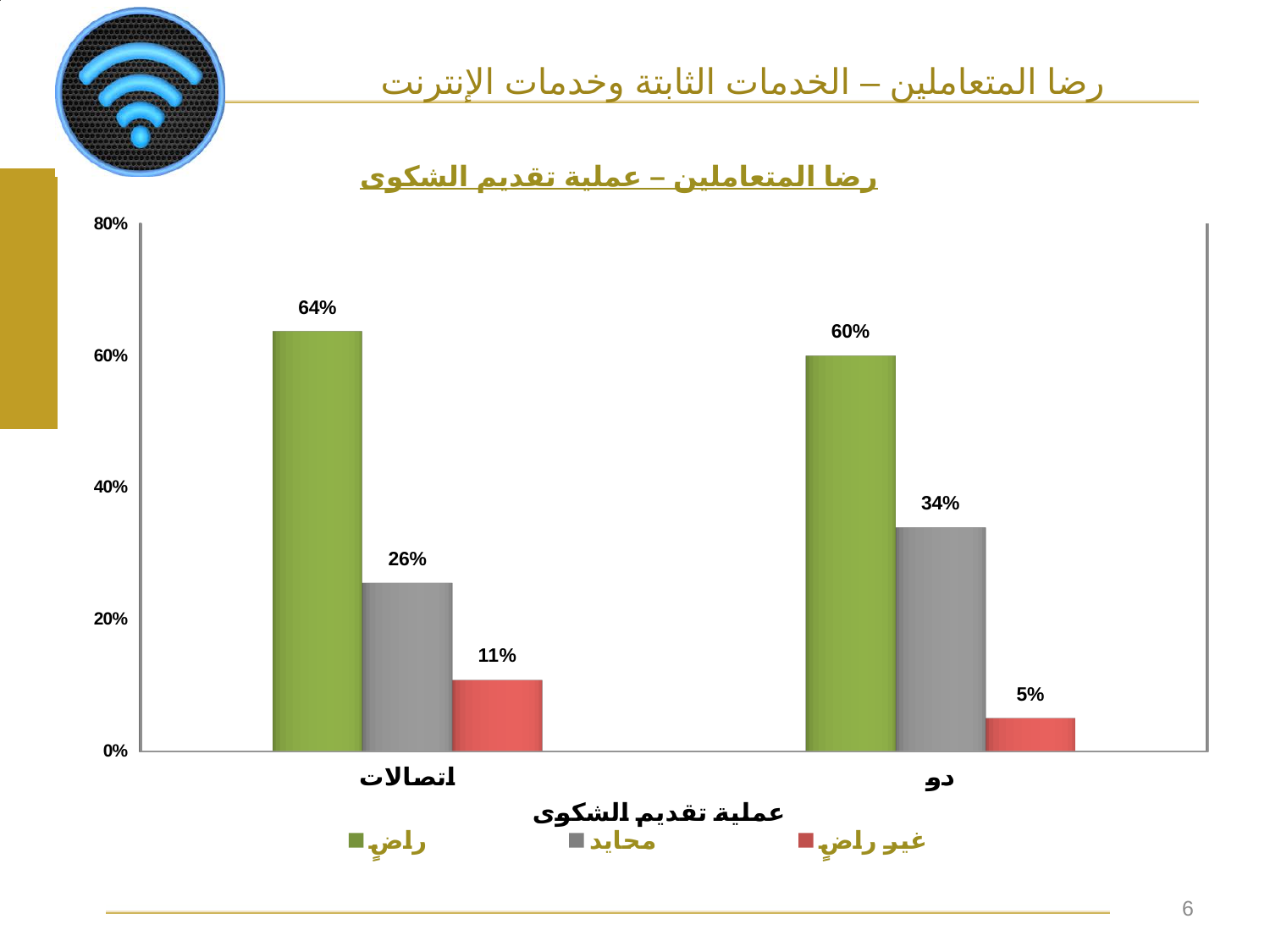
How many series does the legend list? 3 What is the difference between the راضٍ values for اتصالات and دو? 4% Which category has the higher value for راضٍ, اتصالات or دو? اتصالات What is the value for غير راضٍ for اتصالات? 11% What is the value for راضٍ for اتصالات? 64% What is the value for غير راضٍ for دو? 5% What kind of chart is shown on the slide? Bar chart How many categories are shown on the x axis? 2 Which category has the lower value for غير راضٍ? دو What is the value for محايد for دو? 34% What is the difference between the محايد values for دو and اتصالات? 8% What is the title of the chart? رضا المتعاملين – عملية تقديم الشكوى